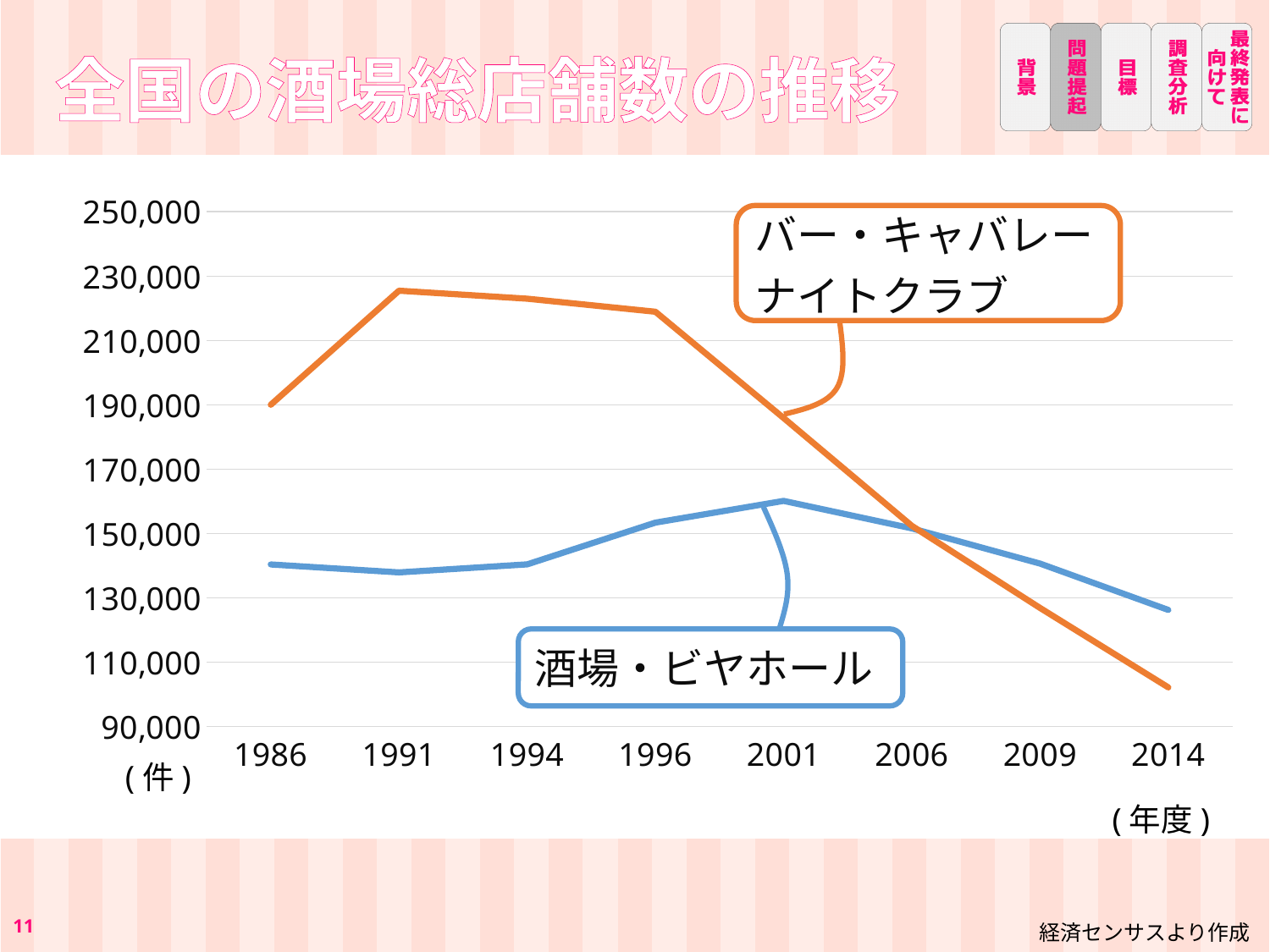
In which year does the 酒場・ビヤホール series reach its lowest value? 2014 Is the value for 酒場・ビヤホール in 2001 greater or less than 150,000? greater Is the value for バー・キャバレー・ナイトクラブ in 1991 greater or less than 210,000? greater How many series are plotted in the chart? 2 In which year does the 酒場・ビヤホール series reach its highest value? 2001 Does the バー・キャバレー・ナイトクラブ series rise or fall from 1996 to 2014? fall What kind of chart is shown on the slide? line chart In which year does the バー・キャバレー・ナイトクラブ series reach its lowest value? 2014 Is the value for バー・キャバレー・ナイトクラブ in 2014 greater or less than 110,000? less In which year does the バー・キャバレー・ナイトクラブ series reach its highest value? 1991 How many years are shown on the x axis of the chart? 8 In 2014, which series has the higher value, バー・キャバレー・ナイトクラブ or 酒場・ビヤホール? 酒場・ビヤホール